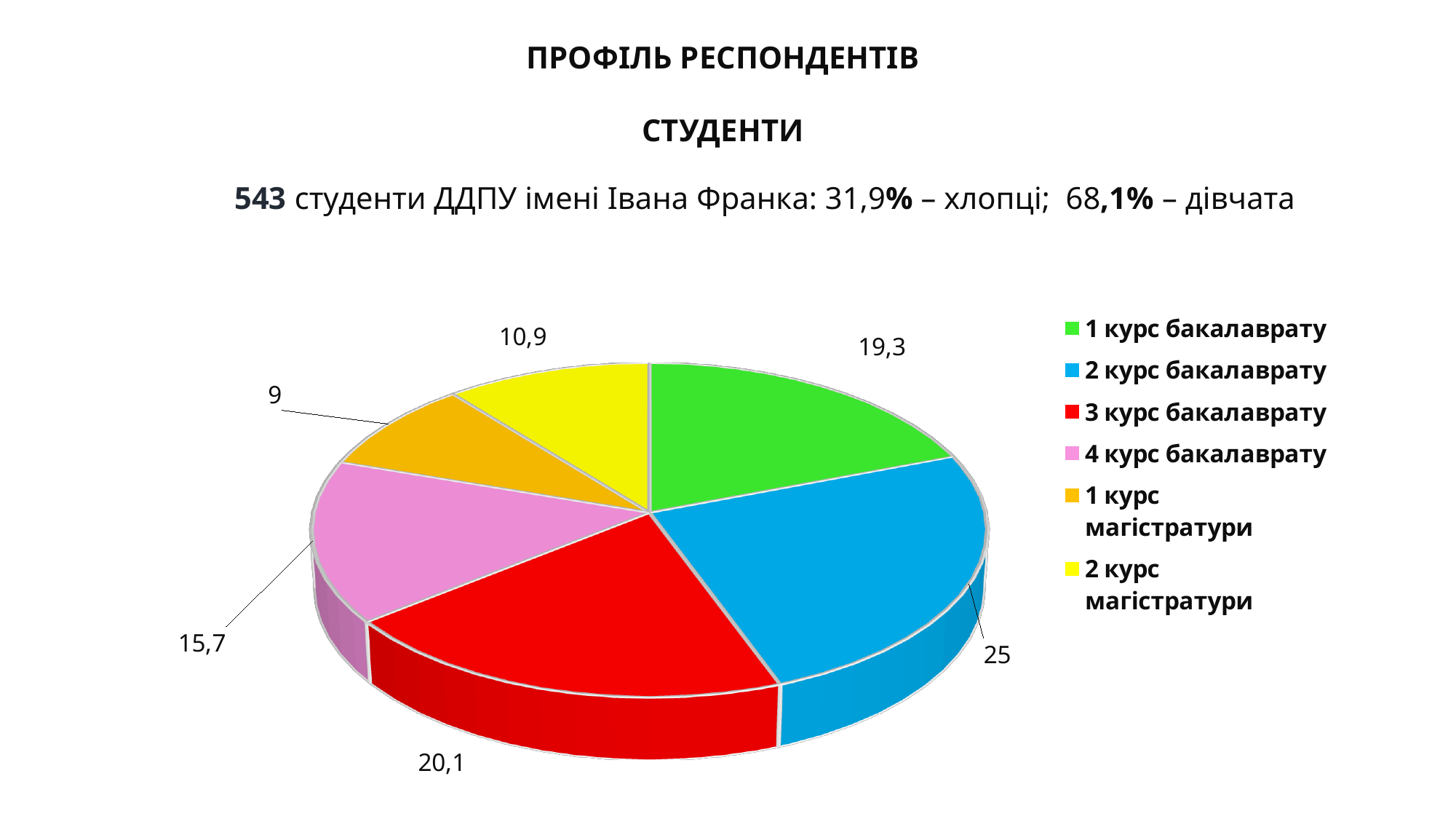
What is the value for 1 курс бакалаврату? 19,3 What is the value for 4 курс бакалаврату? 15,7 Which category has the smallest slice of the pie? 1 курс магістратури Which colour represents 3 курс бакалаврату in the legend? red What is the value for 2 курс бакалаврату? 25 Which is larger: the value for 3 курс бакалаврату or the value for 2 курс магістратури? 3 курс бакалаврату Which category has the largest slice of the pie? 2 курс бакалаврату What is the value for 1 курс магістратури? 9 What is the difference between the values for 2 курс бакалаврату and 1 курс бакалаврату? 5,7 What is the difference between the values for 3 курс бакалаврату and 4 курс бакалаврату? 4,4 How many categories does the pie chart have? 6 What kind of chart is shown on the slide? pie chart